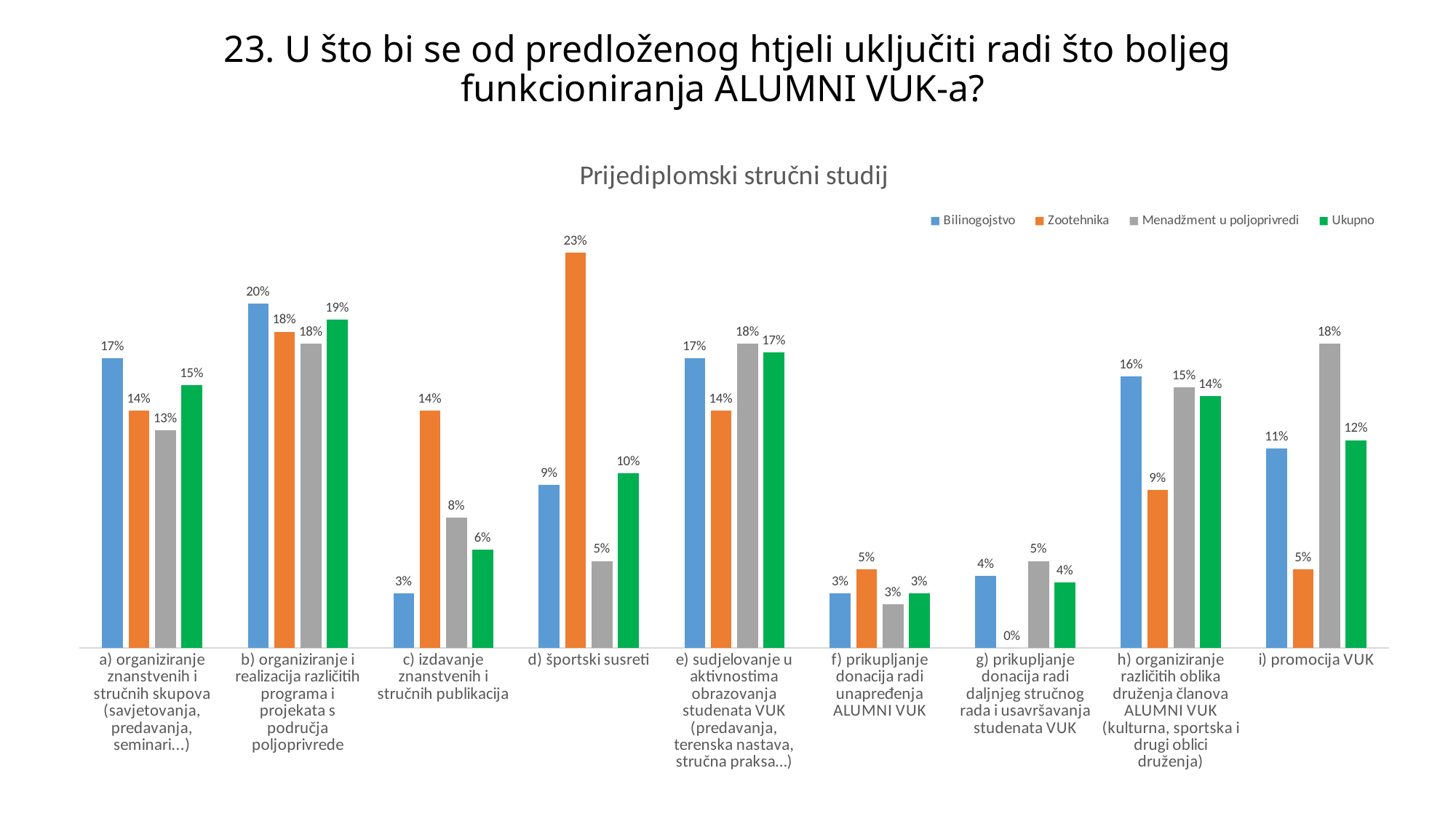
How many categories are shown on the x axis? 9 What is the Menadžment u poljoprivredi value for "i) promocija VUK"? 18% Which category has the lowest Ukupno value? f) prikupljanje donacija radi unapređenja ALUMNI VUK What is the Zootehnika value for "d) športski susreti"? 23% What is the title of the chart? Prijediplomski stručni studij For "c) izdavanje znanstvenih i stručnih publikacija", which is larger: the Zootehnika value or the Menadžment u poljoprivredi value? Zootehnika Which category has the highest Bilinogojstvo value? b) organiziranje i realizacija različitih programa i projekata s područja poljoprivrede What is the Zootehnika value for "g) prikupljanje donacija radi daljnjeg stručnog rada i usavršavanja studenata VUK"? 0% What is the difference between the Zootehnika and Bilinogojstvo values for "d) športski susreti"? 14% What is the Ukupno value for "b) organiziranje i realizacija različitih programa i projekata s područja poljoprivrede"? 19% What kind of chart is shown on the slide? Bar chart How many series does the legend list? 4